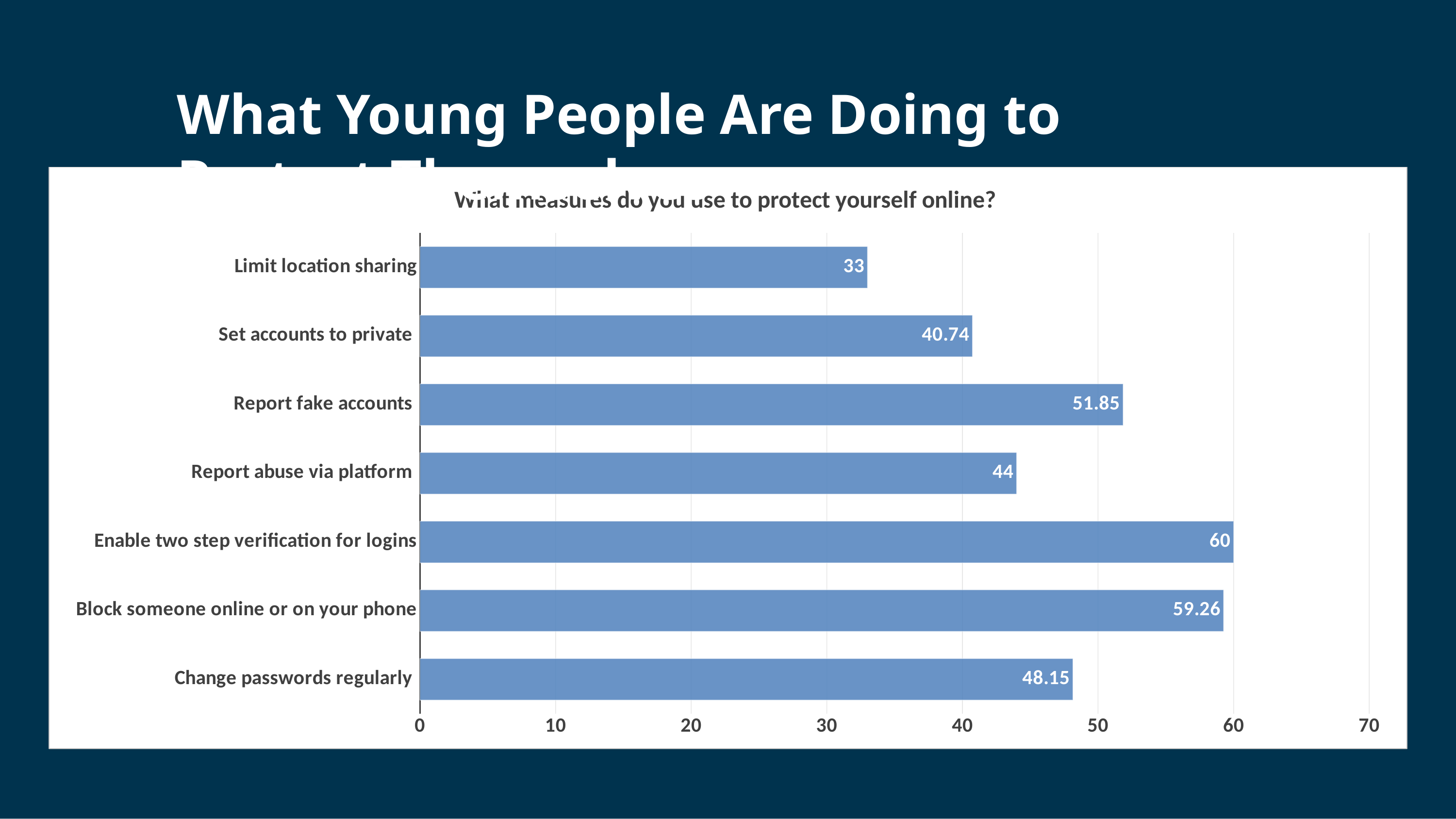
Is the value for Report abuse via platform greater or less than 40? greater Which is larger, the value for Block someone online or on your phone or the value for Change passwords regularly? Block someone online or on your phone What is the title of the chart? What measures do you use to protect yourself online? What is the value for Change passwords regularly? 48.15 How many measures are shown in the chart? 7 What is the highest value shown on the horizontal axis? 70 What is the value for Enable two step verification for logins? 60 What kind of chart is shown on the slide? Bar chart Which measure has the highest value? Enable two step verification for logins What is the difference between the values for Report fake accounts and Report abuse via platform? 7.85 What is the value for Set accounts to private? 40.74 Which measure has the lowest value? Limit location sharing